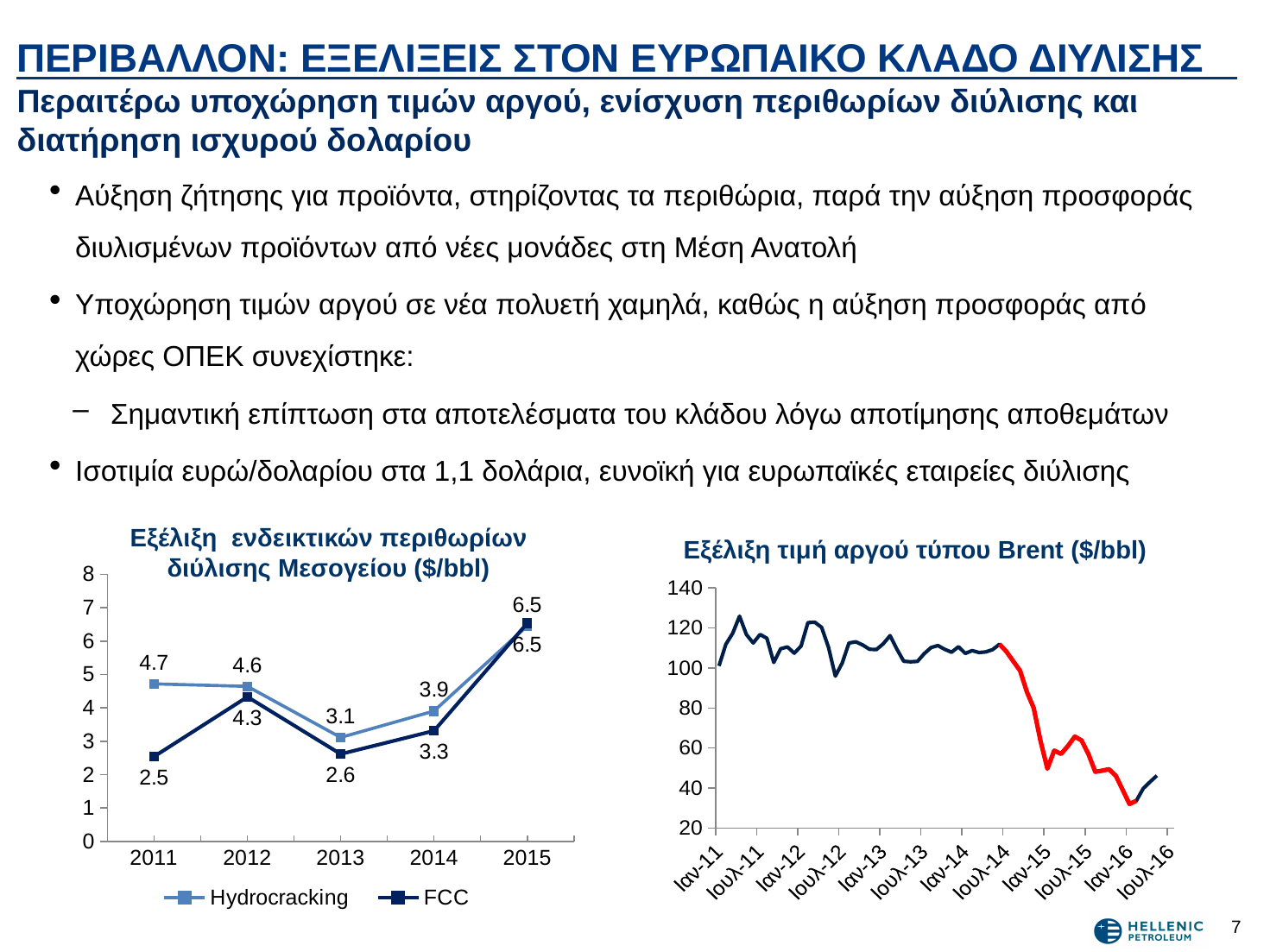
In the right chart (Εξέλιξη τιμή αργού τύπου Brent), is the value at Ιαν-16 greater or less than 60? less In the right chart (Εξέλιξη τιμή αργού τύπου Brent), do values generally rise or fall between Ιουλ-14 and Ιαν-16? fall In the left chart (Εξέλιξη ενδεικτικών περιθωρίων διύλισης Μεσογείου), what is the FCC value for 2013? 2.6 In the left chart (Εξέλιξη ενδεικτικών περιθωρίων διύλισης Μεσογείου), what is the Hydrocracking value for 2011? 4.7 In the left chart (Εξέλιξη ενδεικτικών περιθωρίων διύλισης Μεσογείου), what is the FCC value for 2015? 6.5 In the left chart (Εξέλιξη ενδεικτικών περιθωρίων διύλισης Μεσογείου), which year has the lowest FCC value? 2011 In the left chart (Εξέλιξη ενδεικτικών περιθωρίων διύλισης Μεσογείου), which series has the larger value in 2014, Hydrocracking or FCC? Hydrocracking How many years are shown on the x axis of the left chart (Εξέλιξη ενδεικτικών περιθωρίων διύλισης Μεσογείου)? 5 In the left chart (Εξέλιξη ενδεικτικών περιθωρίων διύλισης Μεσογείου), which year has the highest Hydrocracking value? 2015 In the left chart (Εξέλιξη ενδεικτικών περιθωρίων διύλισης Μεσογείου), what is the difference between the Hydrocracking and FCC values in 2011? 2.2 How many series does the legend of the left chart (Εξέλιξη ενδεικτικών περιθωρίων διύλισης Μεσογείου) list? 2 What kind of chart is the right chart (Εξέλιξη τιμή αργού τύπου Brent)? Line chart